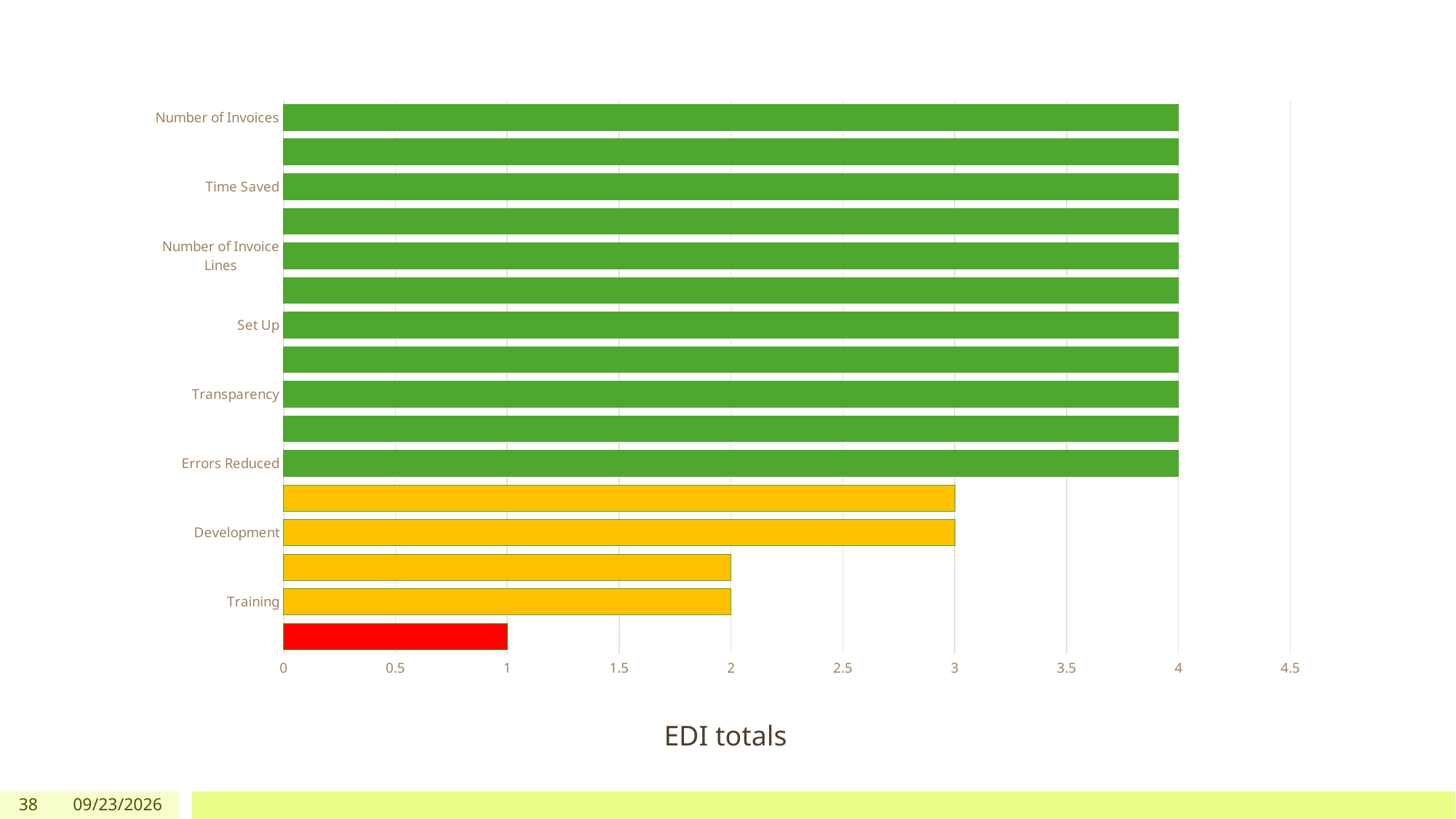
What is the title of the chart? EDI totals Is the value for Training greater or less than 3? less What type of chart is shown on the slide? bar chart Which is larger, the value for Transparency or the value for Development? Transparency How many category labels are shown on the vertical axis? 8 What is the difference between the values for Errors Reduced and Training? 2 What is the difference between the values for Development and Training? 1 What is the value for Number of Invoices? 4 What is the value for Set Up? 4 What is the value for Development? 3 What is the value for Training? 2 Which of the labelled categories has the lowest value? Training